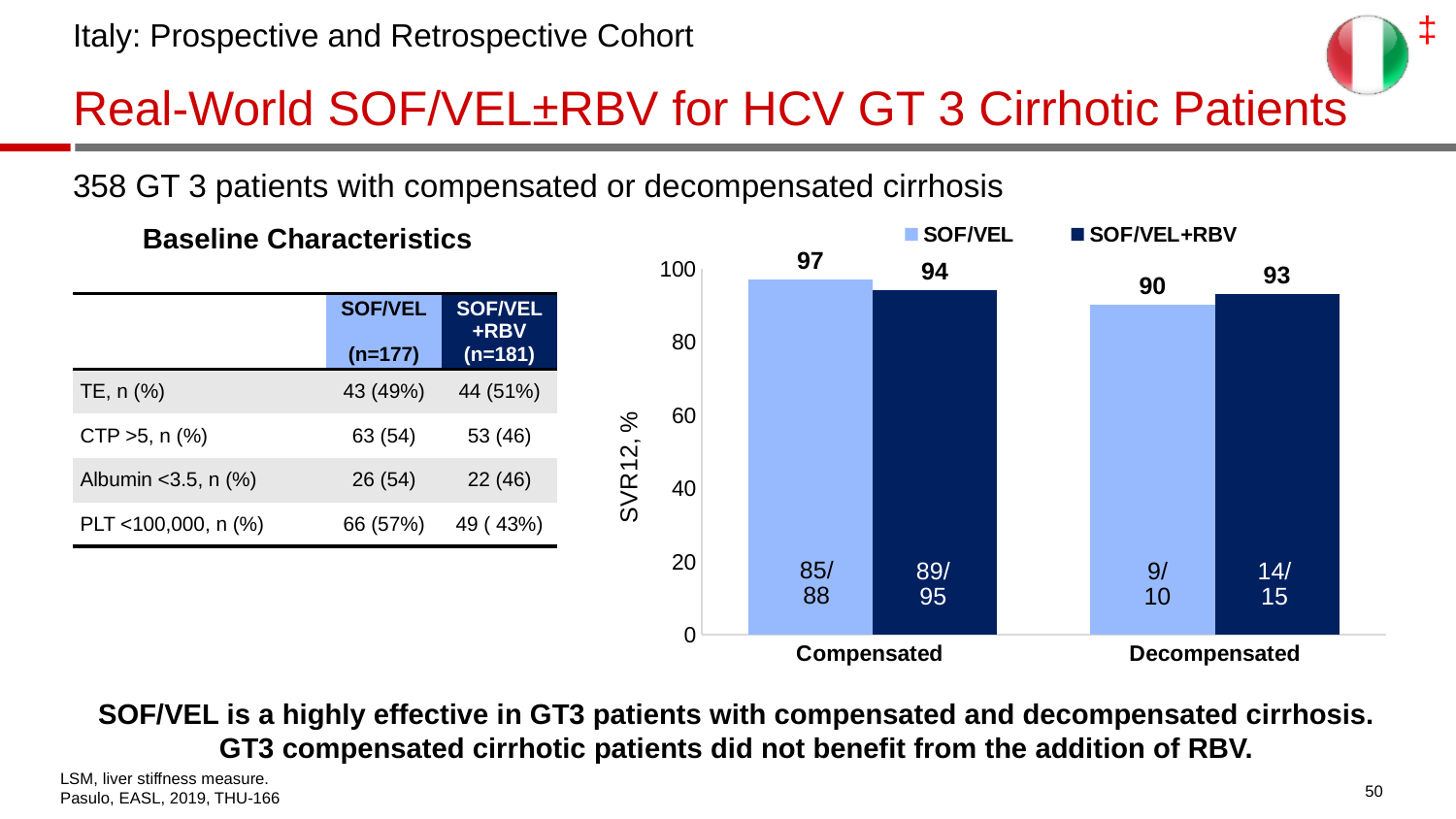
What kind of chart is shown? bar chart What is the y-axis label of the chart? SVR12, % What is the SVR12 rate for SOF/VEL+RBV in decompensated patients? 93 What is the SVR12 rate for SOF/VEL in compensated patients? 97 What is the difference in SVR12 rate between SOF/VEL and SOF/VEL+RBV in compensated patients? 3 How many patients achieved SVR12 out of how many treated with SOF/VEL+RBV in the decompensated group? 14/15 What is the SVR12 rate for SOF/VEL in decompensated patients? 90 Which bar shows the highest SVR12 rate? SOF/VEL, Compensated How many series does the legend list? 2 How many patient categories are shown on the x axis? 2 In decompensated patients, which treatment has the higher SVR12 rate, SOF/VEL or SOF/VEL+RBV? SOF/VEL+RBV Which bar shows the lowest SVR12 rate? SOF/VEL, Decompensated